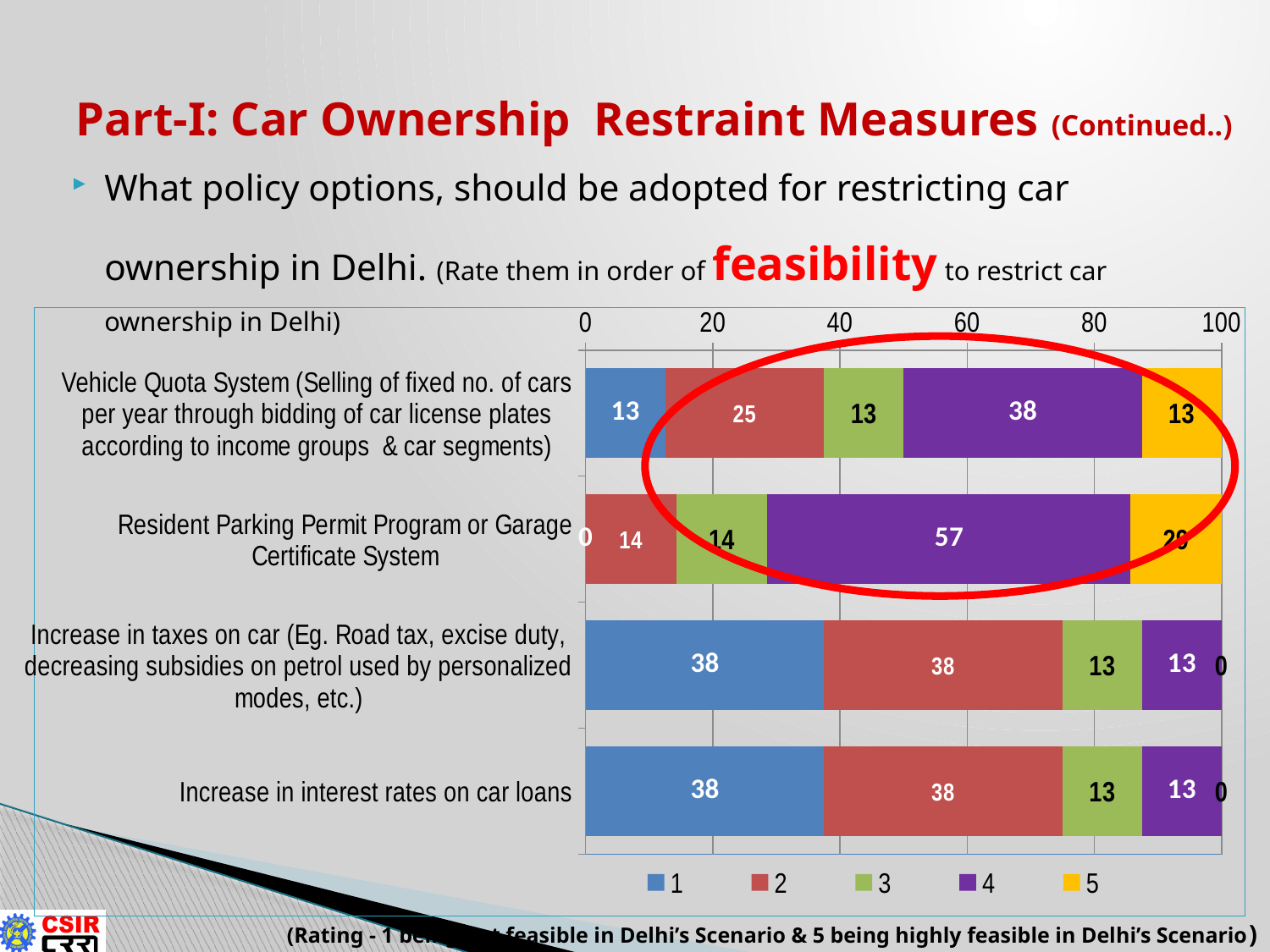
What is the value of series 5 for Increase in taxes on car? 0 What is the value of series 2 for the Vehicle Quota System? 25 Which rating series has the largest segment in the Resident Parking Permit Program bar? 4 What are the legend entries of the chart? 1, 2, 3, 4, 5 What is the value of series 4 for the Resident Parking Permit Program or Garage Certificate System? 57 What is the value of series 1 for Increase in interest rates on car loans? 38 What is the value of series 4 for the Vehicle Quota System? 38 For the Vehicle Quota System, which is larger: the value for series 2 or the value for series 4? Series 4 What is the difference between the series 4 value and the series 1 value for the Vehicle Quota System? 25 How many policy options (categories) are plotted in the chart? 4 What kind of chart is shown on the slide? Stacked bar chart How many series does the legend list? 5